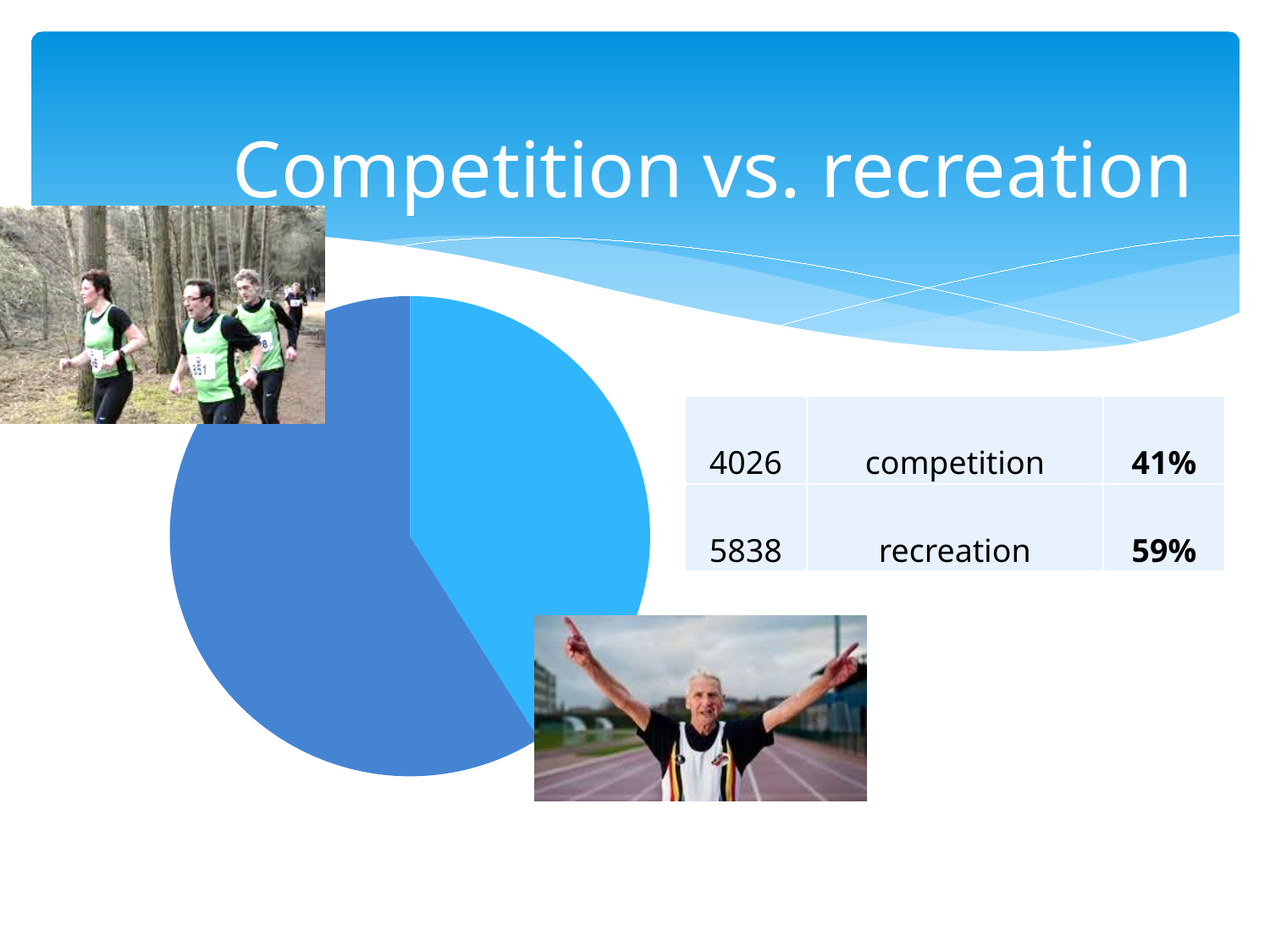
What is the value for recreation? 5838 What is the value for competition? 4026 What is the total of the values for competition and recreation? 9864 What share of the pie does competition represent? 41% How many slices does the pie chart have? 2 Which is larger, the value for competition or the value for recreation? recreation Which category has the smaller share of the pie? competition What kind of chart is shown on the slide? pie chart What is the difference between the value for recreation and the value for competition? 1812 Which category has the larger share of the pie? recreation What share of the pie does recreation represent? 59% What is the title of the slide containing the pie chart? Competition vs. recreation